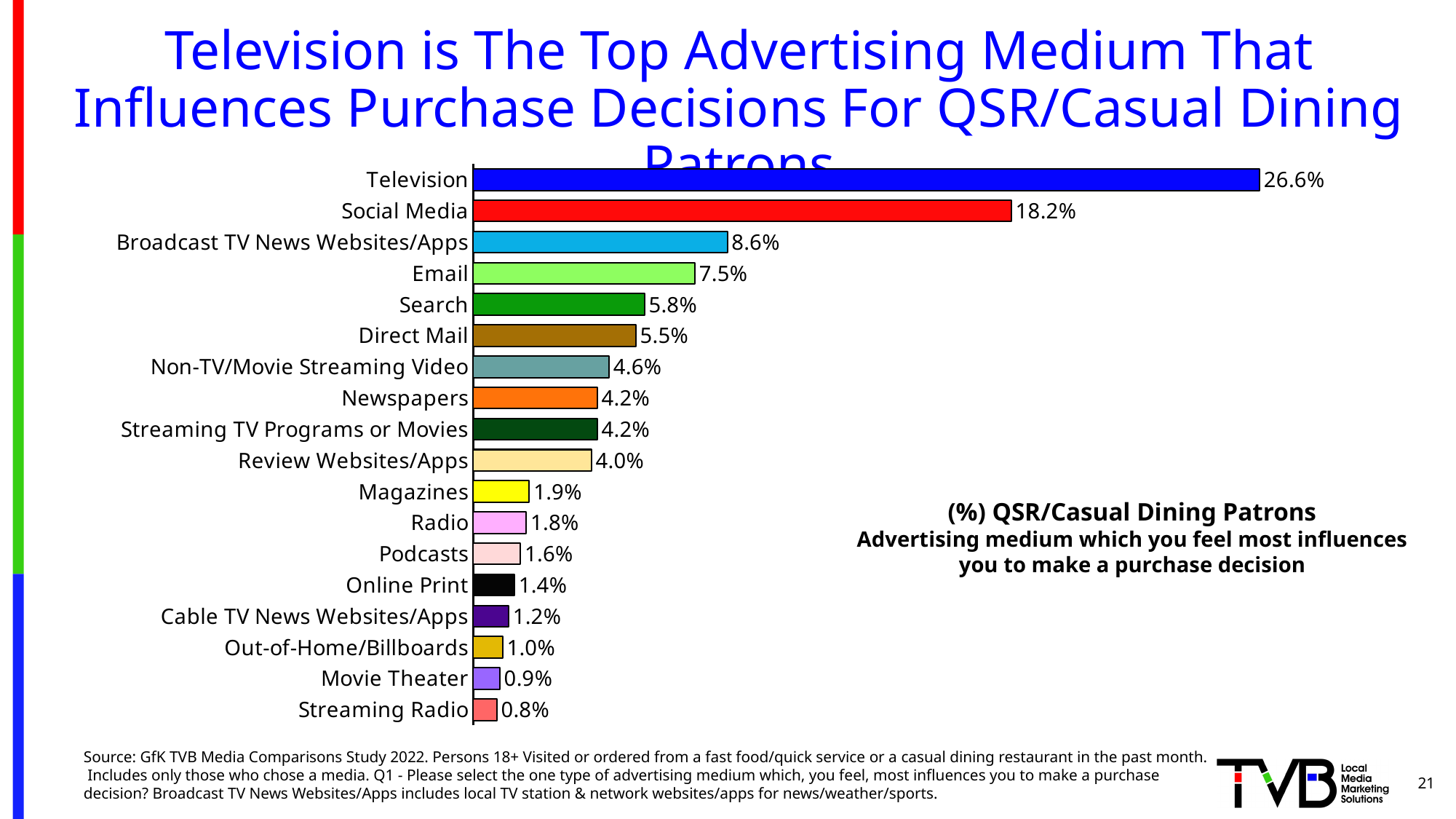
What is the value shown for Podcasts? 1.6% What is the value shown for Direct Mail? 5.5% What percentage of QSR/Casual Dining Patrons chose Television as the advertising medium that most influences their purchase decision? 26.6% What is the difference between the values for Television and Social Media? 8.4% How many advertising media categories are shown on the chart? 18 What is the difference between the values for Broadcast TV News Websites/Apps and Email? 1.1% What colour is the bar for Social Media? Red What is the value shown for Social Media? 18.2% Which advertising medium has the highest value on the chart? Television Which has a larger value, Search or Non-TV/Movie Streaming Video? Search Which advertising medium has the lowest value on the chart? Streaming Radio What kind of chart is shown on the slide? Bar chart